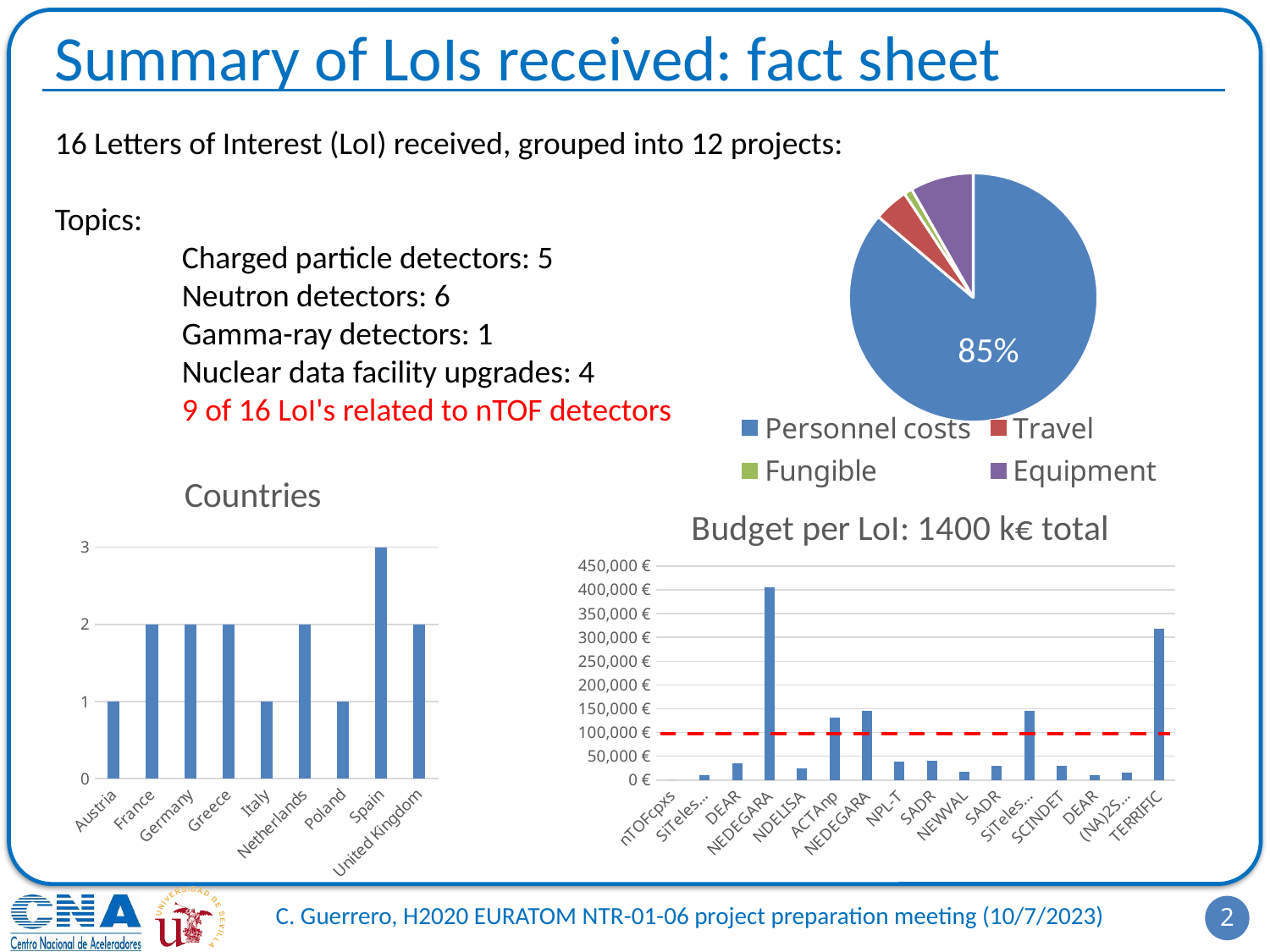
In the Budget per LoI chart, which LoI has the highest budget? NEDEGARA In the pie chart at the top right, what share does Personnel costs have? 85% In the Countries chart, what is the value for Spain? 3 In the Budget per LoI chart, is the value for TERRIFIC greater or less than 300,000 €? greater In the Countries chart, what is the value for Austria? 1 How many entries does the legend of the pie chart at the top right list? 4 In the Countries chart, which is larger, the value for France or the value for Poland? France In the Countries chart, which country has the highest value? Spain How many countries are shown in the Countries chart? 9 How many LoIs are shown on the x axis of the Budget per LoI chart? 16 In the Countries chart, what is the difference between the values for Spain and Italy? 2 What kind of chart is the Countries chart? bar chart